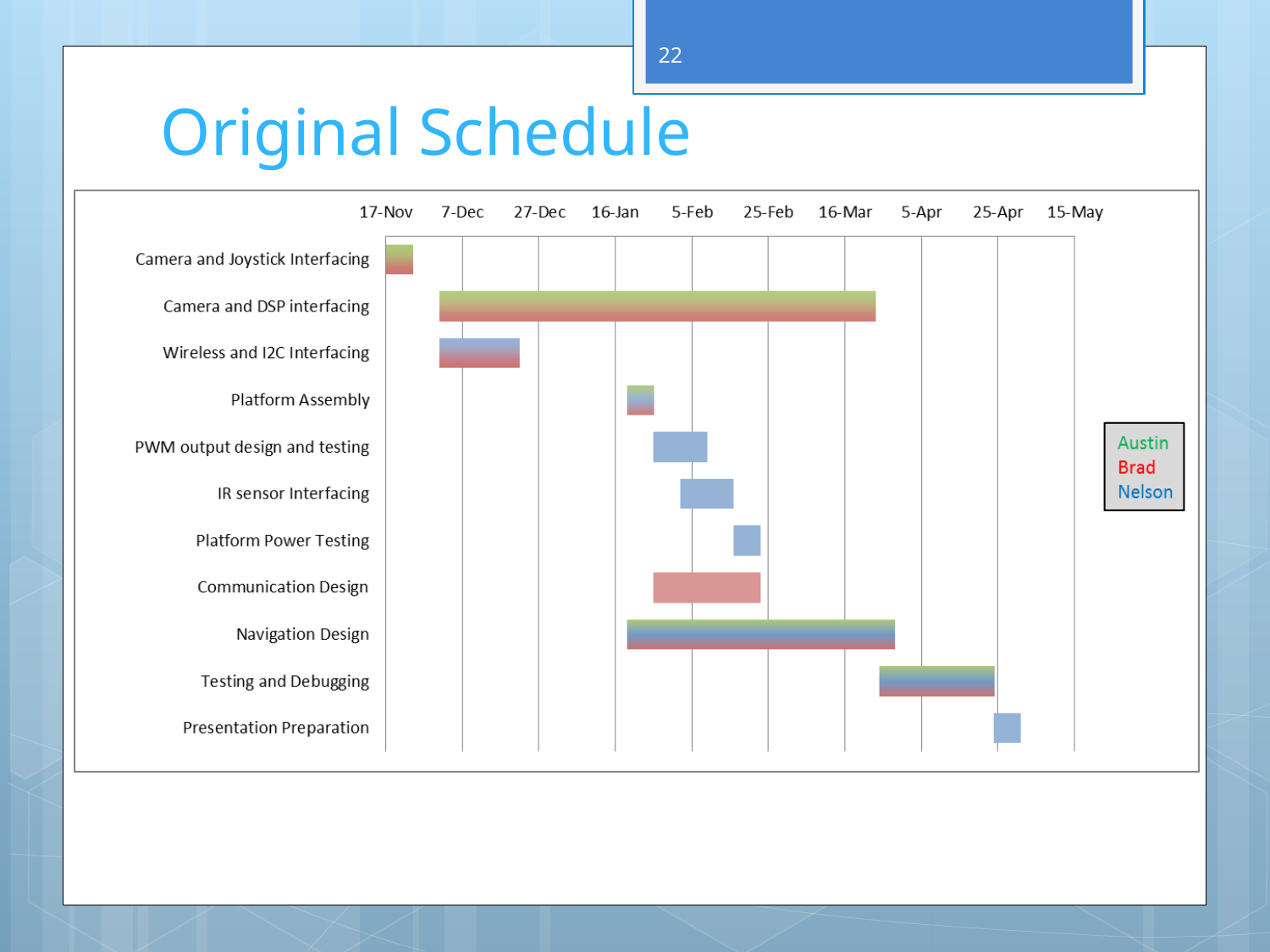
Which task has a longer bar, Camera and DSP interfacing or Wireless and I2C Interfacing? Camera and DSP interfacing What kind of chart is shown on the slide? Gantt chart (horizontal bar chart) Does the Navigation Design task end before or after 16-Mar? after Which task starts earliest in the schedule? Camera and Joystick Interfacing Does the PWM output design and testing task start before or after 5-Feb? before How many tasks are listed on the vertical axis of the chart? 11 Which task starts earlier, Communication Design or Platform Power Testing? Communication Design What is the title of the chart slide? Original Schedule Which task has the longest bar in the chart? Camera and DSP interfacing Which task ends last in the schedule? Presentation Preparation How many names does the legend list? 3 According to the legend colours, which person is assigned to Communication Design? Brad